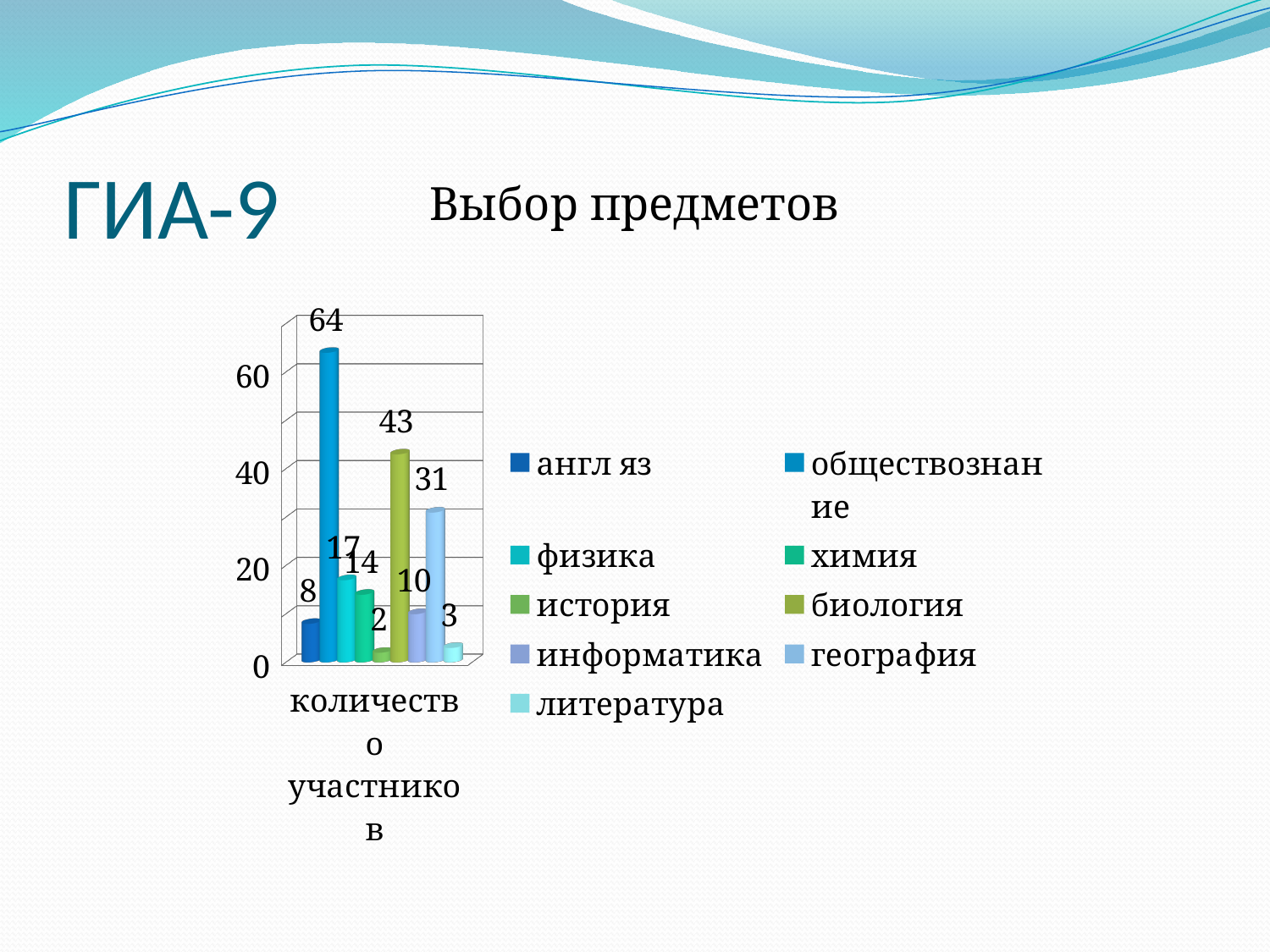
What is the value for биология? 43 What is the value for география? 31 Which subject has the lowest number of participants? история What is the value for физика? 17 What is the title of the chart? Выбор предметов What is the difference between the values for обществознание and биология? 21 What is the value for обществознание? 64 What kind of chart is shown on the slide? bar chart Which subject has the highest number of participants? обществознание What is the difference between the values for география and литература? 28 Which is larger, the value for химия or the value for информатика? химия How many series does the legend list? 9